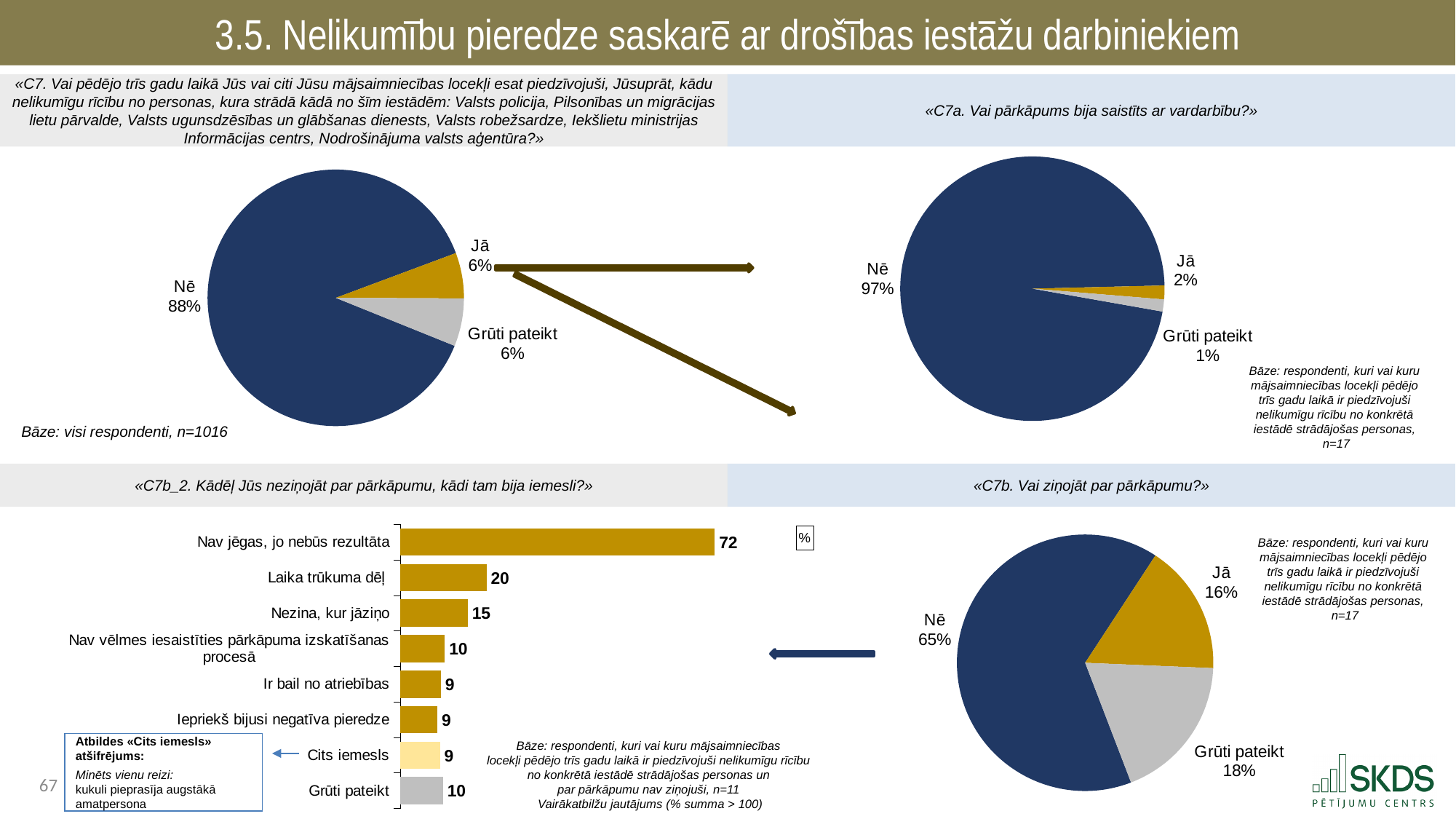
What type of chart is used for question C7b_2 in the bottom-left of the slide? Bar chart In the bottom-right pie chart (C7b), which answer has the largest slice? Nē In the bottom-left bar chart (C7b_2), what is the value for "Nav jēgas, jo nebūs rezultāta"? 72 In the top-left pie chart (C7), what share of respondents answered "Jā"? 6% In the bottom-right pie chart (C7b), what is the difference between the "Grūti pateikt" and "Jā" shares? 2% In the bottom-left bar chart (C7b_2), how many categories are shown? 8 In the top-right pie chart (C7a), what share answered "Grūti pateikt"? 1% In the top-left pie chart (C7), what share of respondents answered "Nē"? 88% In the bottom-left bar chart (C7b_2), what is the value for "Nezina, kur jāziņo"? 15 In the bottom-right pie chart (C7b), what share answered "Jā"? 16% In the top-right pie chart (C7a), what share answered "Nē"? 97% In the bottom-left bar chart (C7b_2), what is the difference between "Laika trūkuma dēļ" and "Nav vēlmes iesaistīties pārkāpuma izskatīšanas procesā"? 10